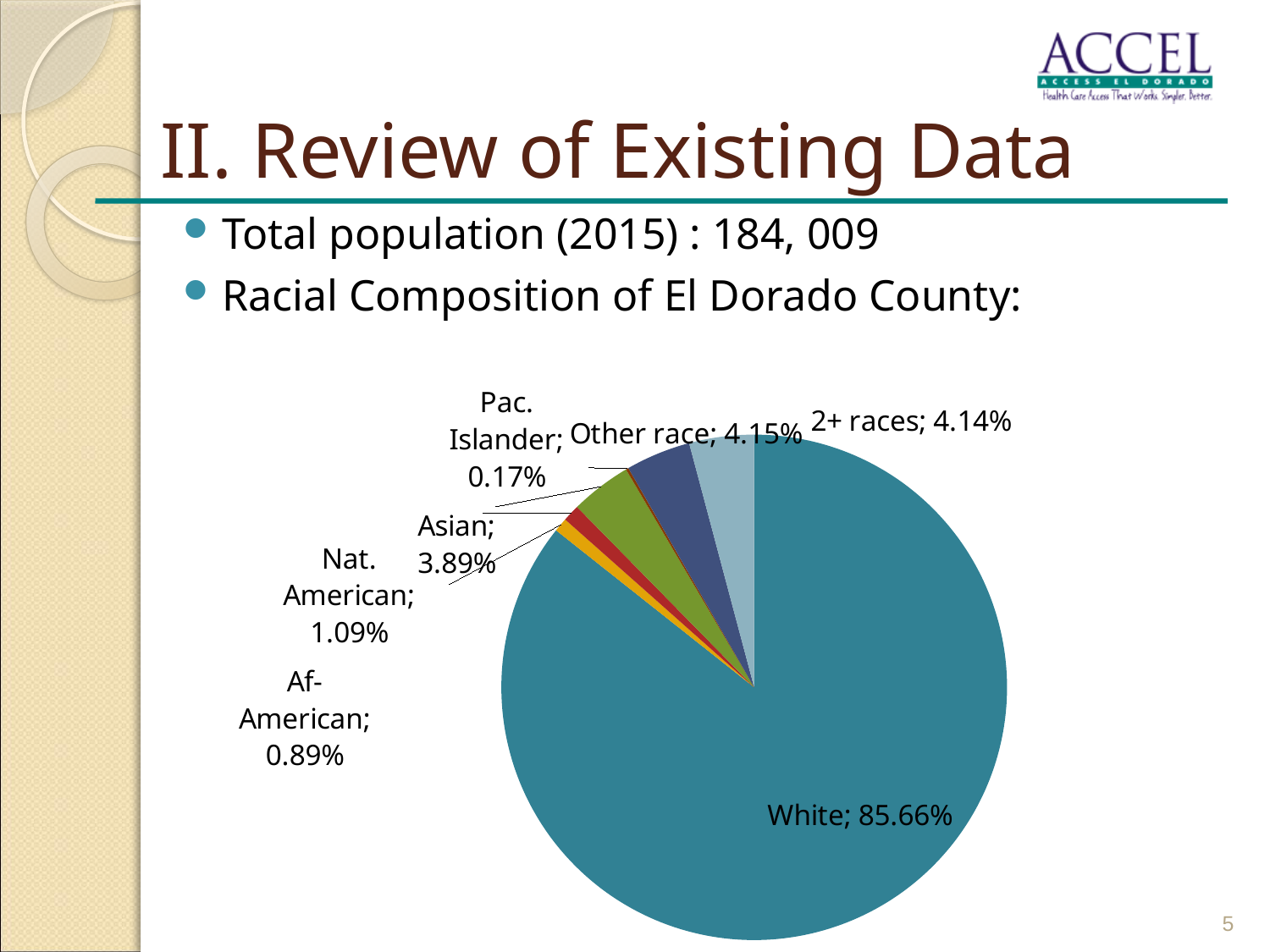
What is the difference between the share for Nat. American and the share for Af-American? 0.20% Which is larger, the share for Asian or the share for Nat. American? Asian What is the value shown for Asian? 3.89% Which category has the largest slice of the pie? White What is the value shown for Nat. American? 1.09% What is the difference between the share for Other race and the share for 2+ races? 0.01% How many slices does the pie chart have? 7 What is the value shown for Pac. Islander? 0.17% What share of the pie does the White slice represent? 85.66% Which category has the smallest slice of the pie? Pac. Islander What is the value shown for Af-American? 0.89% What kind of chart is shown on the slide? pie chart